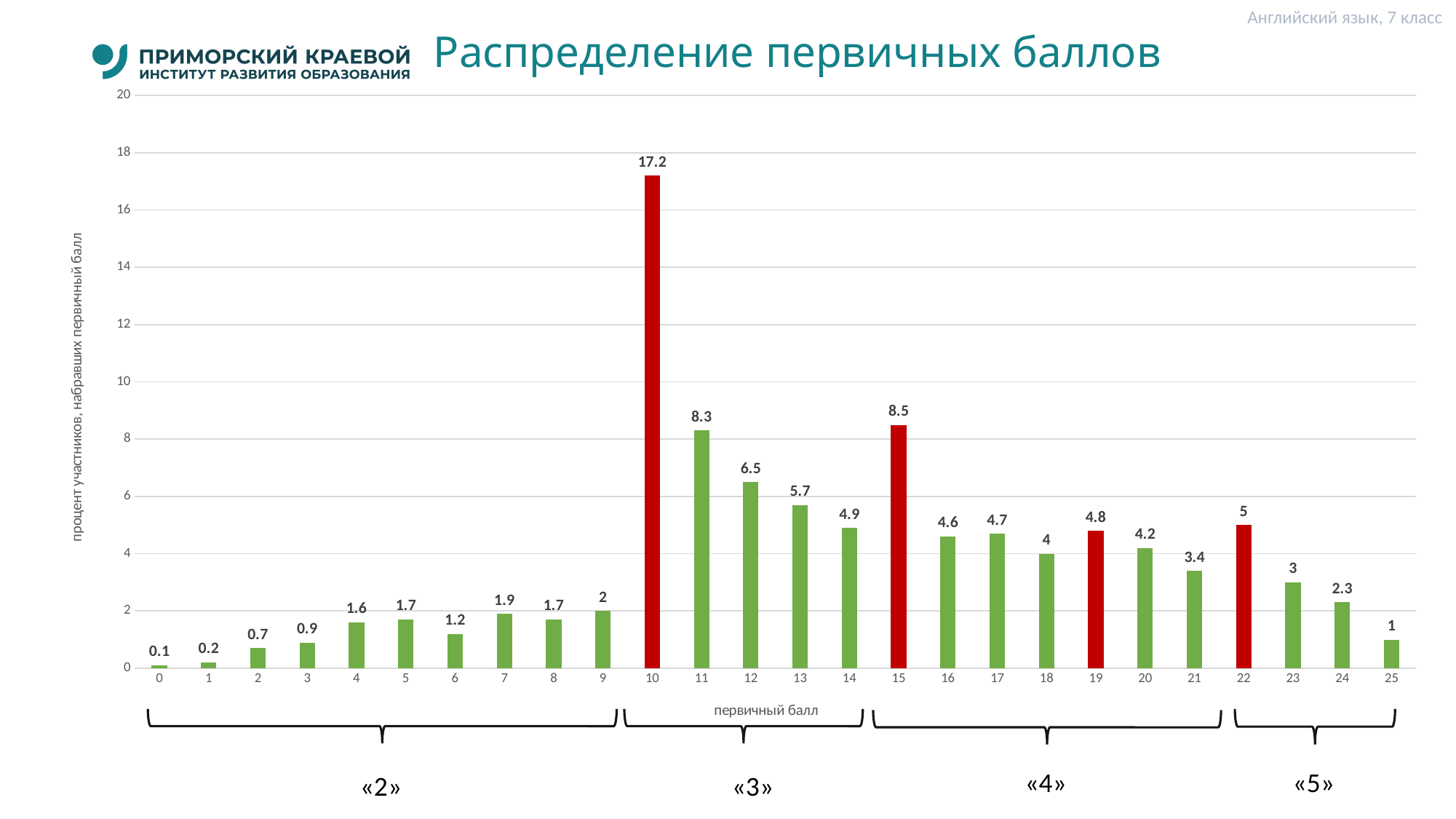
What is the value for primary score 22? 5 What is the value for primary score 15? 8.5 Which is larger, the value for primary score 12 or for primary score 15? 15 How many primary score categories are shown on the x axis? 26 Which primary score has the lowest percentage of participants? 0 Which primary score has the highest percentage of participants? 10 What is the difference between the values for primary scores 10 and 11? 8.9 What kind of chart is shown on the slide? bar chart What is the title of the chart? Распределение первичных баллов Is the value for primary score 11 greater or less than 8? greater Do the values rise or fall from primary score 22 to primary score 25? fall What is the value for primary score 10? 17.2